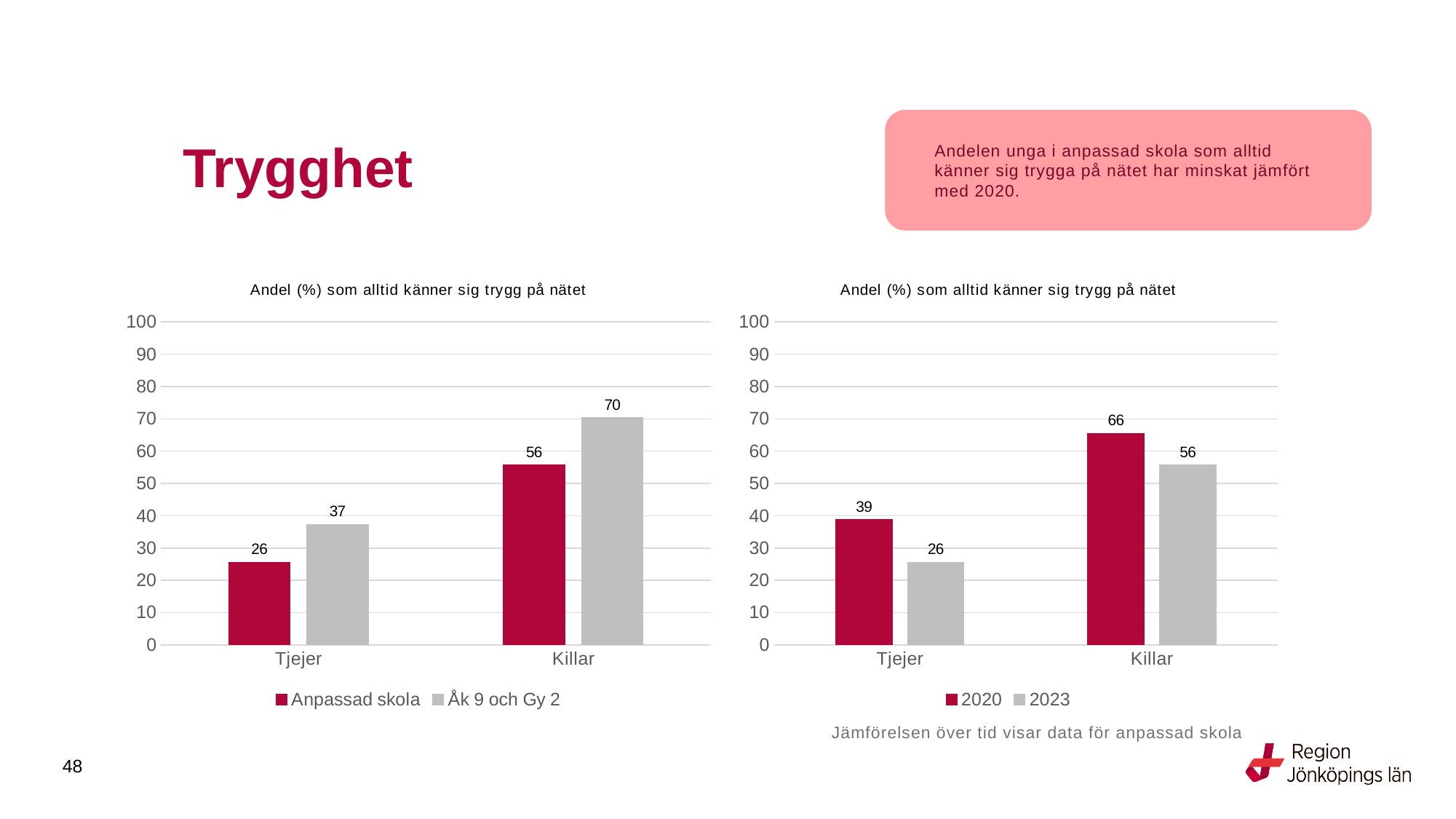
What type of chart is the left chart? Bar chart In the right chart, what is the value for Tjejer in 2020? 39 In the left chart, what is the difference between the Åk 9 och Gy 2 and Anpassad skola values for Killar? 14 In the left chart, which category has the highest value in the Åk 9 och Gy 2 series? Killar What are the two series named in the legend of the left chart? Anpassad skola and Åk 9 och Gy 2 In the right chart, which is larger for Killar: the 2020 value or the 2023 value? 2020 In the right chart, by how much did the value for Tjejer fall from 2020 to 2023? 13 How many series does the legend of the right chart list? 2 In the right chart, which category has the lowest value in the 2023 series? Tjejer In the right chart, what is the value for Killar in 2023? 56 In the left chart, what is the value for Tjejer in the Åk 9 och Gy 2 series? 37 In the left chart, what is the value for Killar in the Anpassad skola series? 56